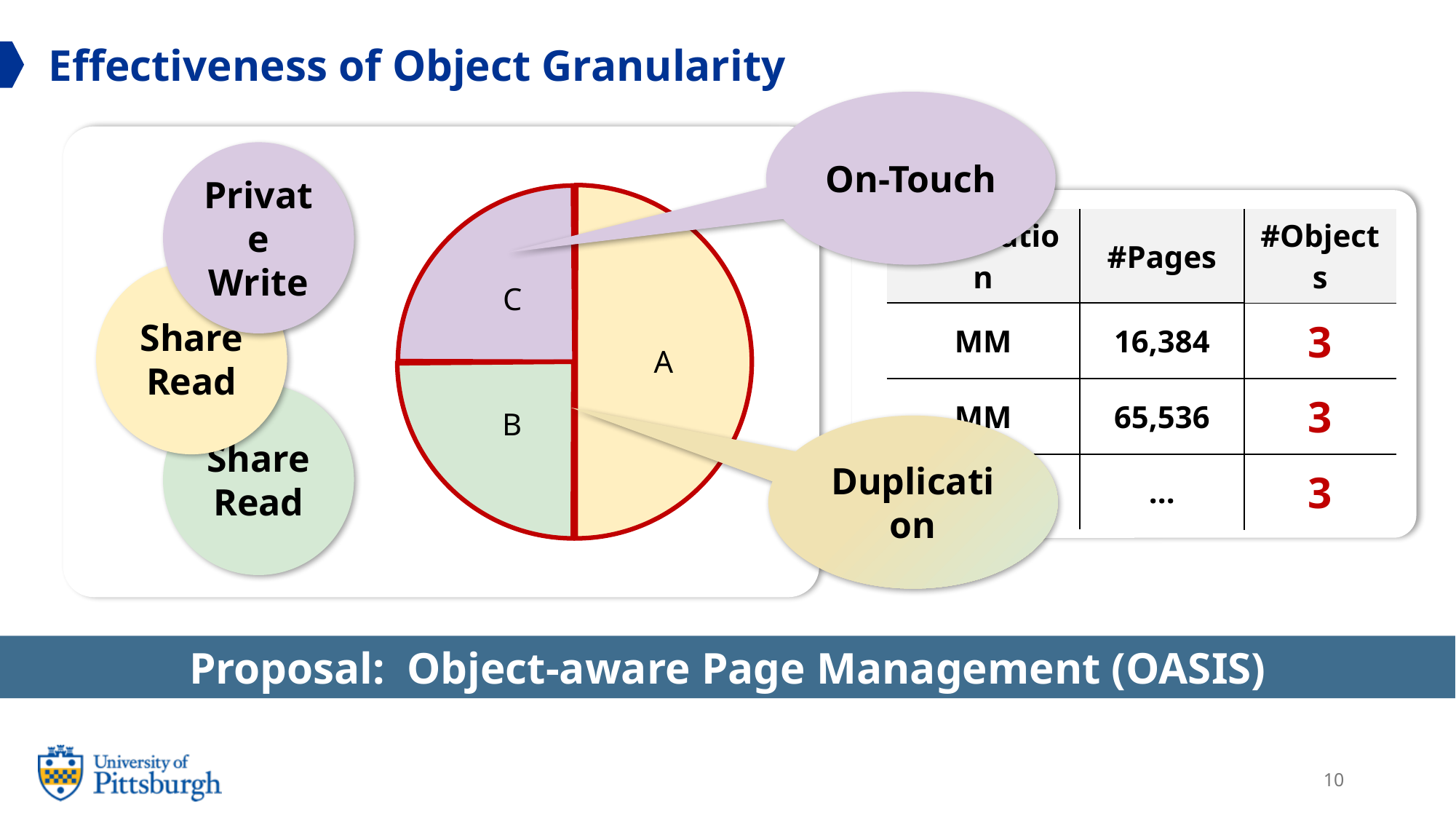
What colour is slice A in the pie chart? yellow Which is larger in the pie chart, slice C or slice A? A How many slices does the pie chart have? 3 Which slice of the pie chart is the largest? A What are the labels of the three slices in the pie chart? A, B, C Which is larger in the pie chart, slice A or slice B? A What kind of chart is shown in the middle of the slide? pie chart